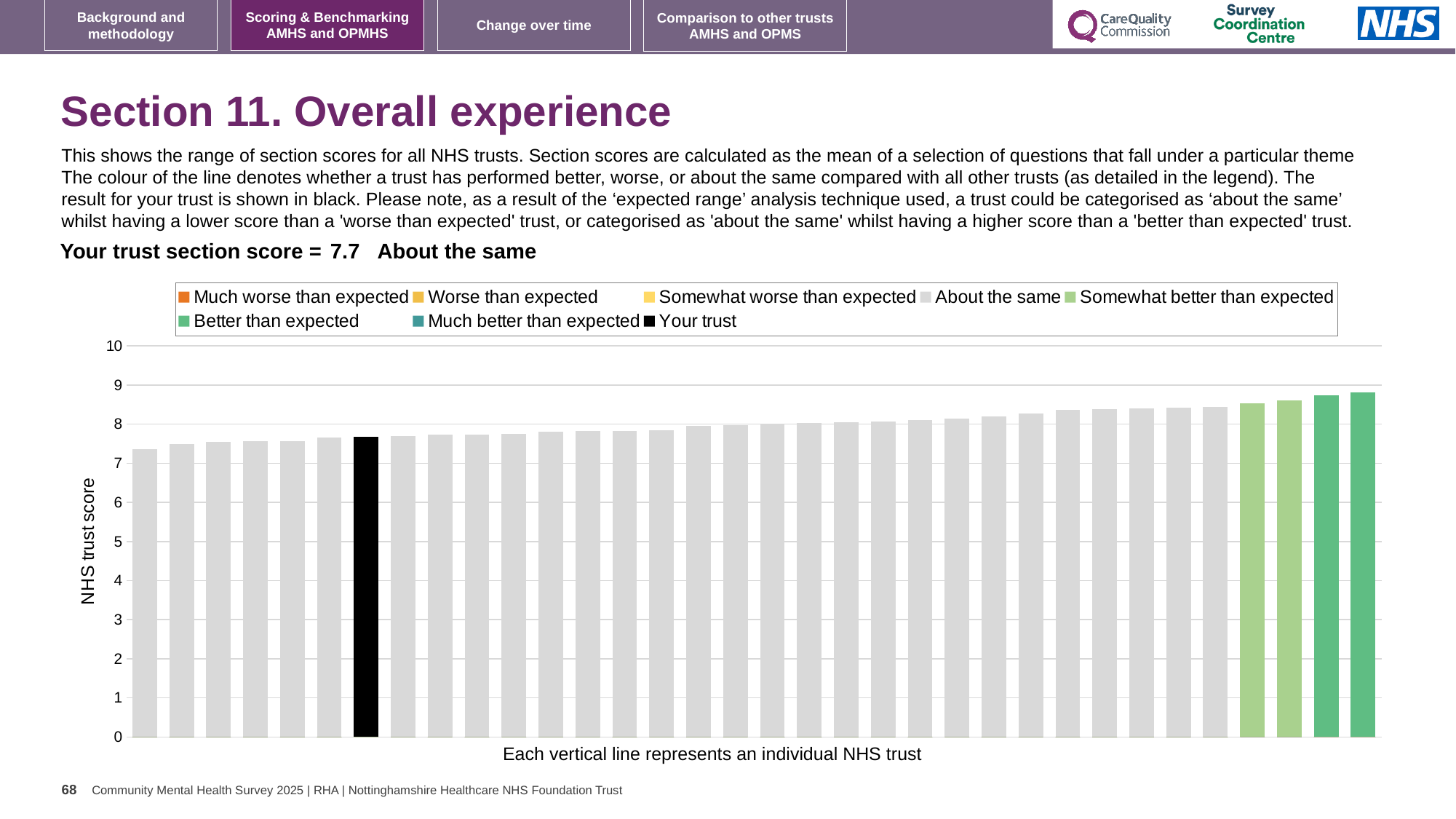
How is your trust categorised compared with other trusts in this section? About the same Is the shortest bar in the chart greater or less than 7? greater How many bars in the chart are coloured green? 4 What is the section score for your trust shown on the slide? 7.7 Is the tallest bar in the chart greater or less than 8? greater Is the value for your trust (the black bar) greater or less than 8? less How many entries does the chart legend list? 8 What is the label on the vertical axis of the chart? NHS trust score What kind of chart is shown on the slide? Bar chart What colour is the bar representing your trust? Black Do the bar values rise or fall from left to right across the chart? rise